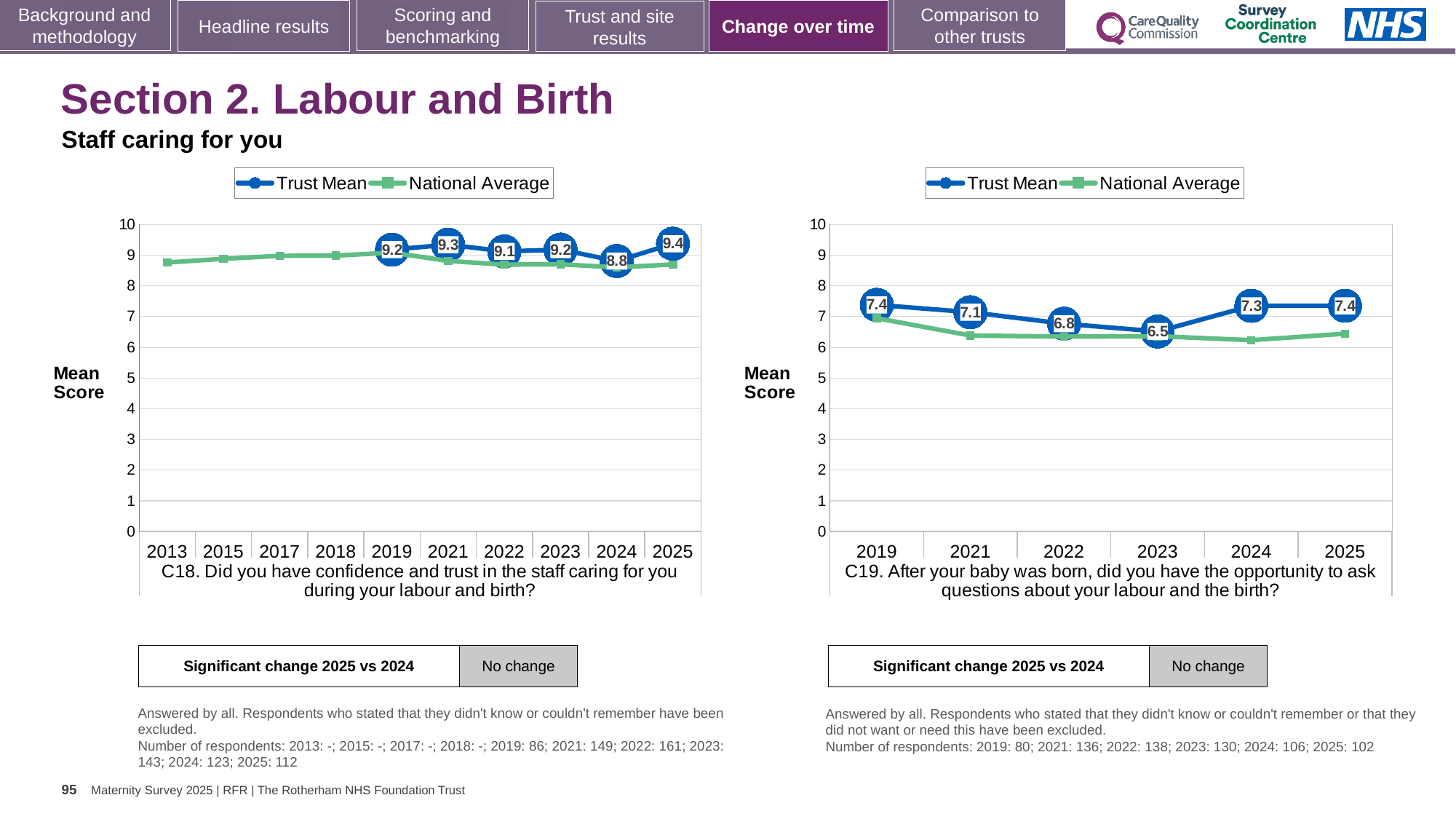
In the C19 chart on the right, what is the Trust Mean score for 2023? 6.5 In the C18 chart on the left, which year has the lowest Trust Mean score? 2024 In the C18 chart on the left, what is the Trust Mean score for 2024? 8.8 What type of chart is the C19 chart on the right? Line chart In the C18 chart on the left, what is the difference between the Trust Mean scores for 2025 and 2024? 0.6 In the C19 chart on the right, how many series does the legend list? 2 In the C18 chart on the left, what is the Trust Mean score for 2025? 9.4 In the C18 chart on the left, is the National Average value for 2013 greater or less than 8? greater In the C19 chart on the right, is the Trust Mean score for 2021 larger or smaller than the score for 2024? smaller In the C19 chart on the right, is the National Average value for 2024 greater or less than 7? less In the C19 chart on the right, which year has the lowest Trust Mean score? 2023 In the C18 chart on the left, how many years are shown on the x axis? 10